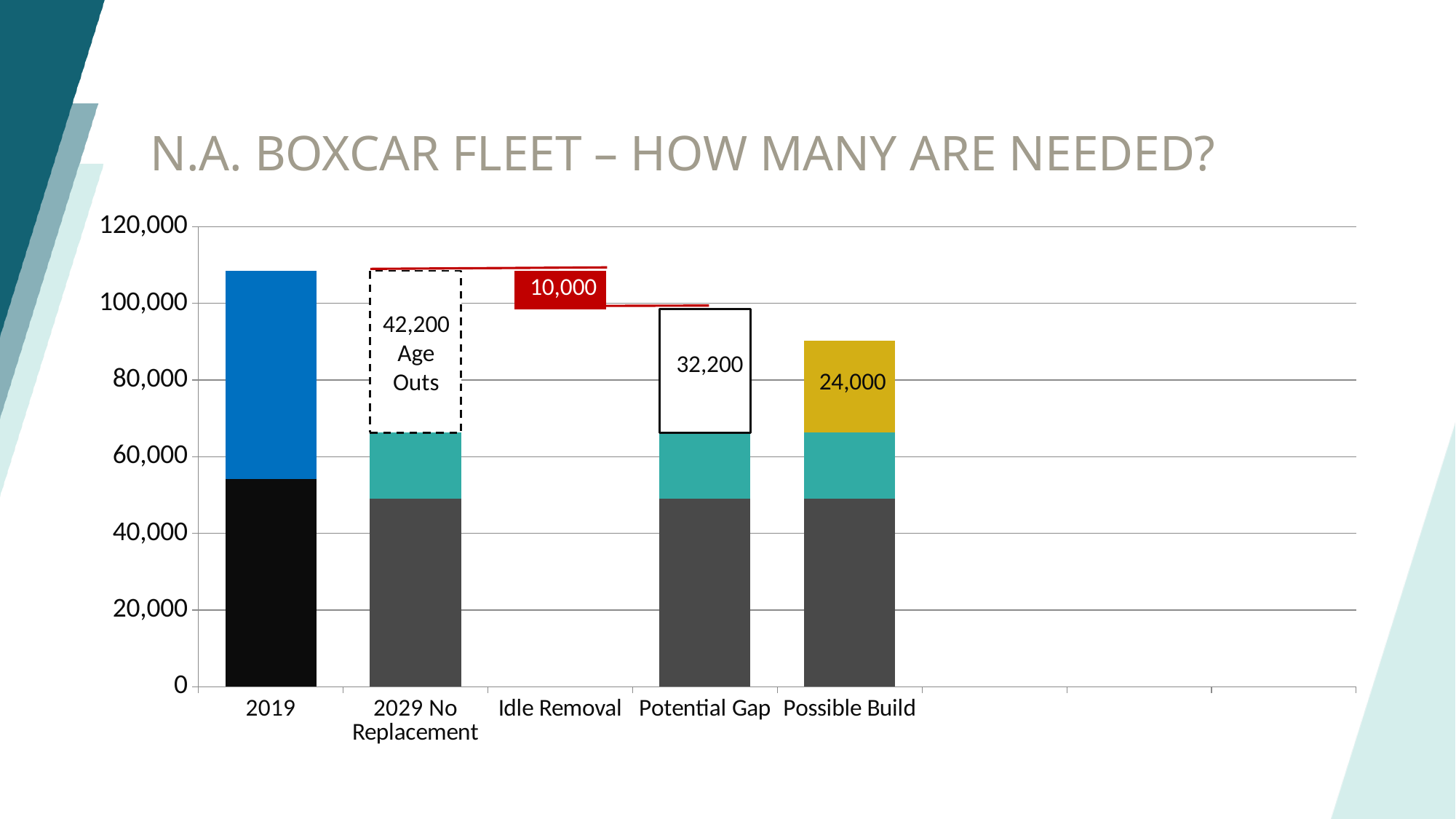
How many categories are labelled along the x axis of the chart? 5 What is the difference between the Potential Gap value (32,200) and the Possible Build value (24,000)? 8,200 What is the difference between the Age Outs value (42,200) and the Potential Gap value (32,200)? 10,000 Which is larger, the Potential Gap value or the Possible Build value? Potential Gap Is the total height of the Possible Build bar greater or less than 100,000? less What is the title of the chart on the slide? N.A. BOXCAR FLEET – HOW MANY ARE NEEDED? How many Age Outs are labelled in the 2029 No Replacement bar? 42,200 What value is labelled on the top segment of the Possible Build bar? 24,000 Is the total height of the 2019 bar greater or less than 100,000? greater What value is labelled for Potential Gap? 32,200 What kind of chart is shown on the slide? bar chart What value is labelled for Idle Removal? 10,000